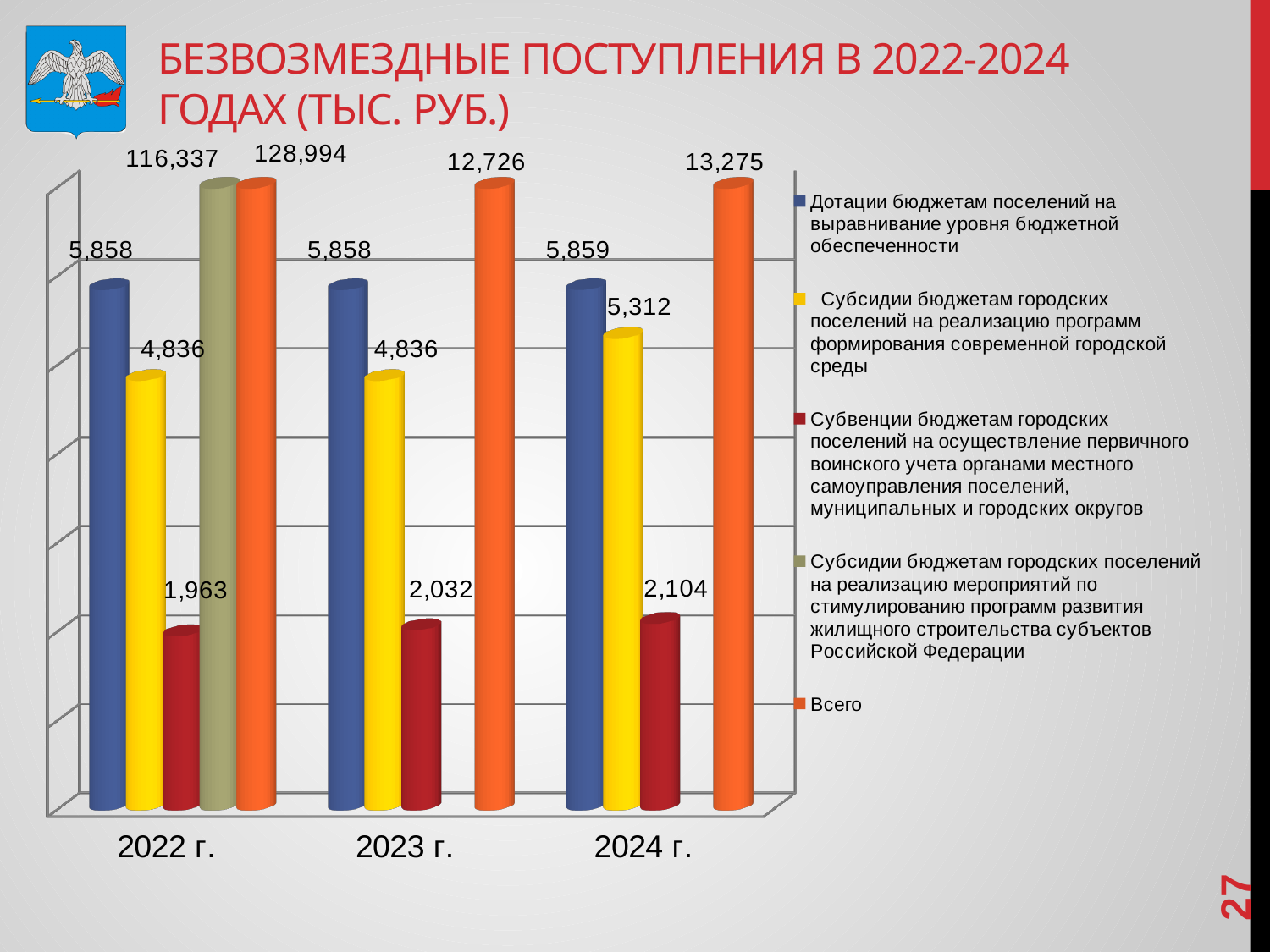
What is the value of "Всего" for 2022 г.? 128,994 In which year is the "Субвенции" (dark red) value the lowest? 2022 г. What is the value of "Субсидии бюджетам городских поселений на реализацию мероприятий по стимулированию программ развития жилищного строительства субъектов Российской Федерации" for 2022 г.? 116,337 In which year is the "Всего" value the highest? 2022 г. Do the "Субвенции" (dark red) values rise or fall from 2022 г. to 2024 г.? Rise What is the value of "Субсидии бюджетам городских поселений на реализацию программ формирования современной городской среды" for 2024 г.? 5,312 What is the value of "Всего" for 2024 г.? 13,275 What kind of chart is shown on the slide? Bar chart What is the value of "Субвенции бюджетам городских поселений на осуществление первичного воинского учета" for 2023 г.? 2,032 How many series does the legend list? 5 What is the difference between the "Всего" values for 2024 г. and 2023 г.? 549 Which is larger: the "Дотации" value for 2024 г. or the "Субсидии на формирование современной городской среды" value for 2024 г.? Дотации (5,859)